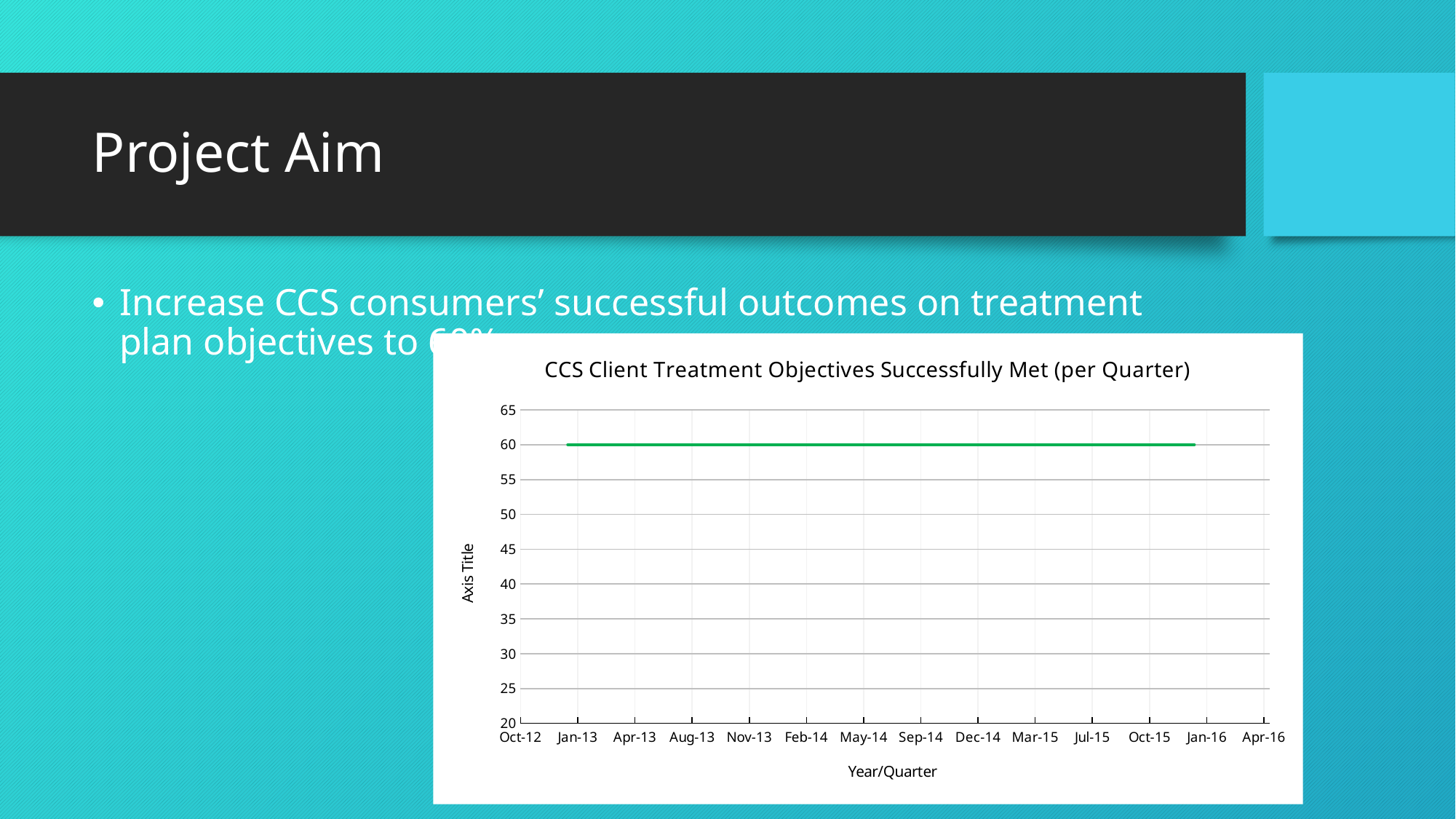
What is the label on the x axis of the chart? Year/Quarter What kind of chart is shown on the slide? line chart How many tick labels are shown along the x axis of the chart? 14 Does the plotted line rise, fall, or stay flat across the x axis? stay flat Is the value of the green line at Jul-15 greater or less than 65? less What is the lowest value shown on the y axis of the chart? 20 At what value on the y axis does the green line sit? 60 What is the title of the chart? CCS Client Treatment Objectives Successfully Met (per Quarter) Is the value of the green line at Apr-13 greater or less than 40? greater